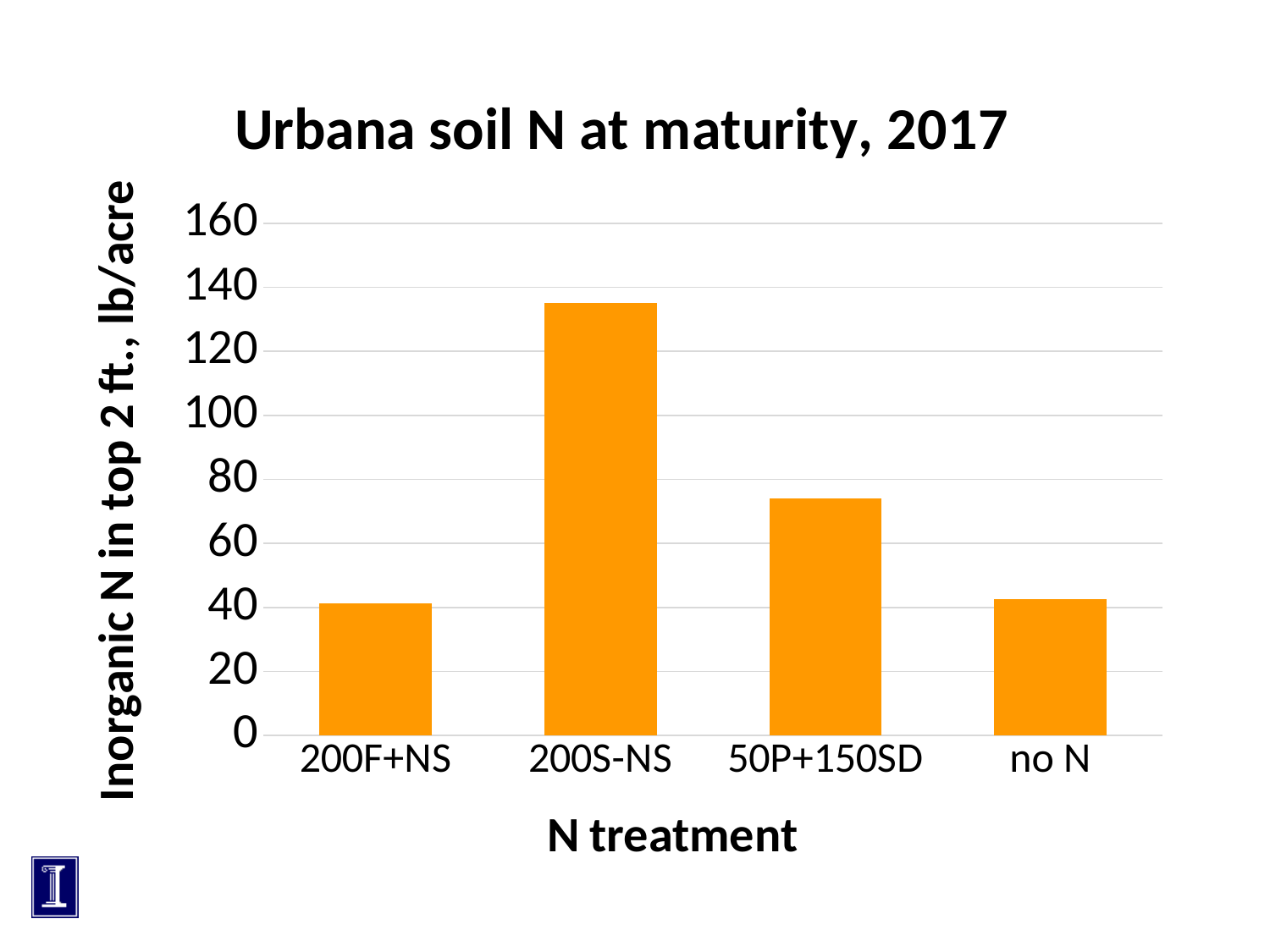
Is the value for 50P+150SD greater or less than 80? less What is the title of the chart? Urbana soil N at maturity, 2017 What kind of chart is shown on the slide? bar chart Is the value for 200F+NS greater or less than 60? less How many N treatments are shown on the x axis? 4 Is the value for 50P+150SD greater or less than 60? greater Which has a higher value, 200S-NS or 50P+150SD? 200S-NS Which N treatment has the highest inorganic N in the top 2 ft.? 200S-NS Which has a higher value, 50P+150SD or no N? 50P+150SD